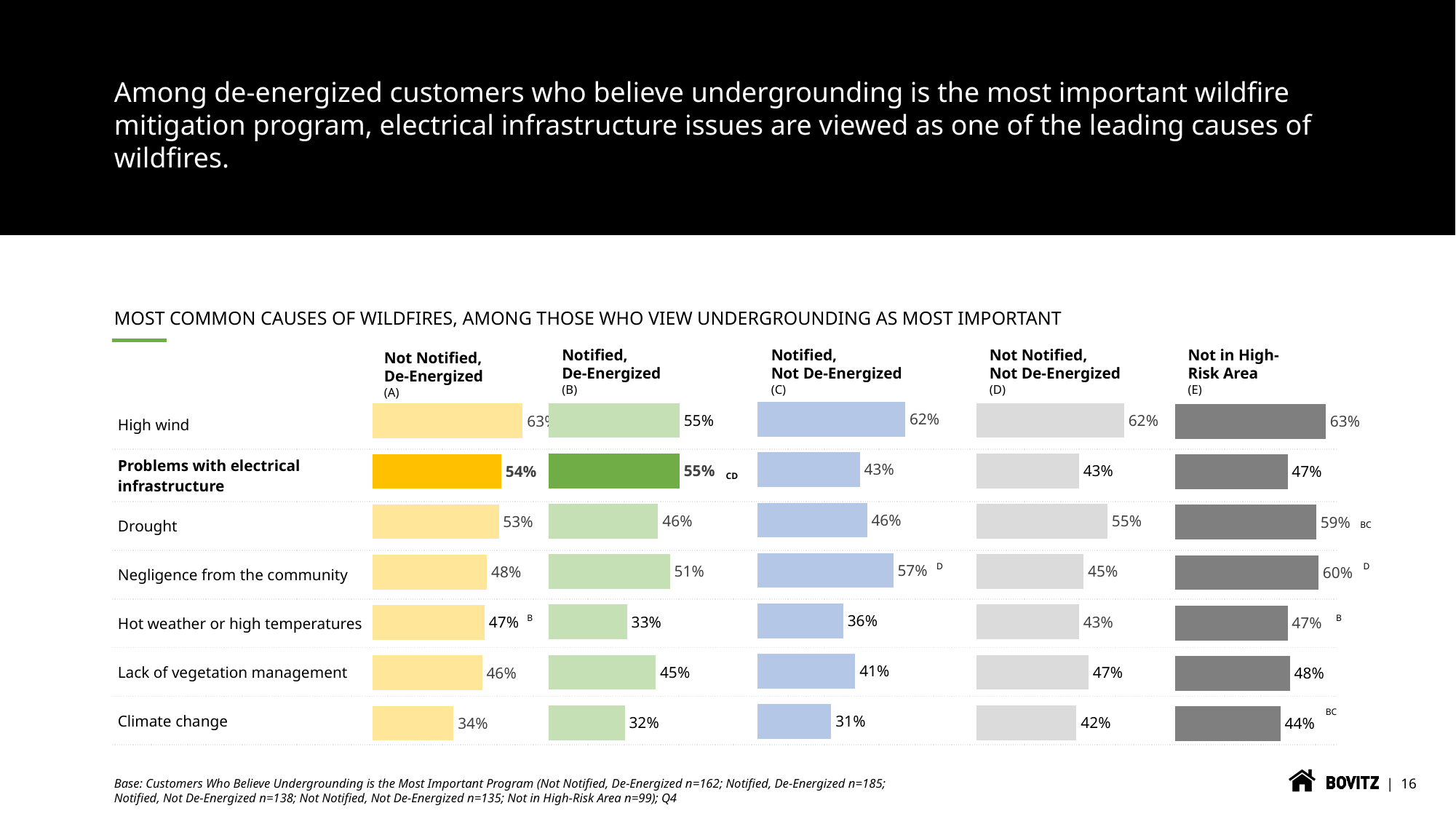
In the Notified, Not De-Energized chart, which cause has the highest percentage? High wind In the Not Notified, Not De-Energized chart, what is the value for Lack of vegetation management? 47% How many wildfire causes are listed in the charts? 7 What kind of chart is used to show the wildfire causes? Bar chart How many customer segment columns are shown on the slide? 5 In the Not Notified, Not De-Energized chart, which cause has the lowest percentage? Climate change In the Notified, De-Energized chart, what is the value for Hot weather or high temperatures? 33% In the Notified, Not De-Energized chart, which is larger: Negligence from the community or Problems with electrical infrastructure? Negligence from the community In the Not Notified, De-Energized chart, what is the difference between Problems with electrical infrastructure and Climate change? 20 percentage points In the Notified, De-Energized chart, which cause has the lowest percentage? Climate change In the Not in High-Risk Area chart, what is the value for Drought? 59% In the Notified, De-Energized chart, what percentage cite problems with electrical infrastructure? 55%